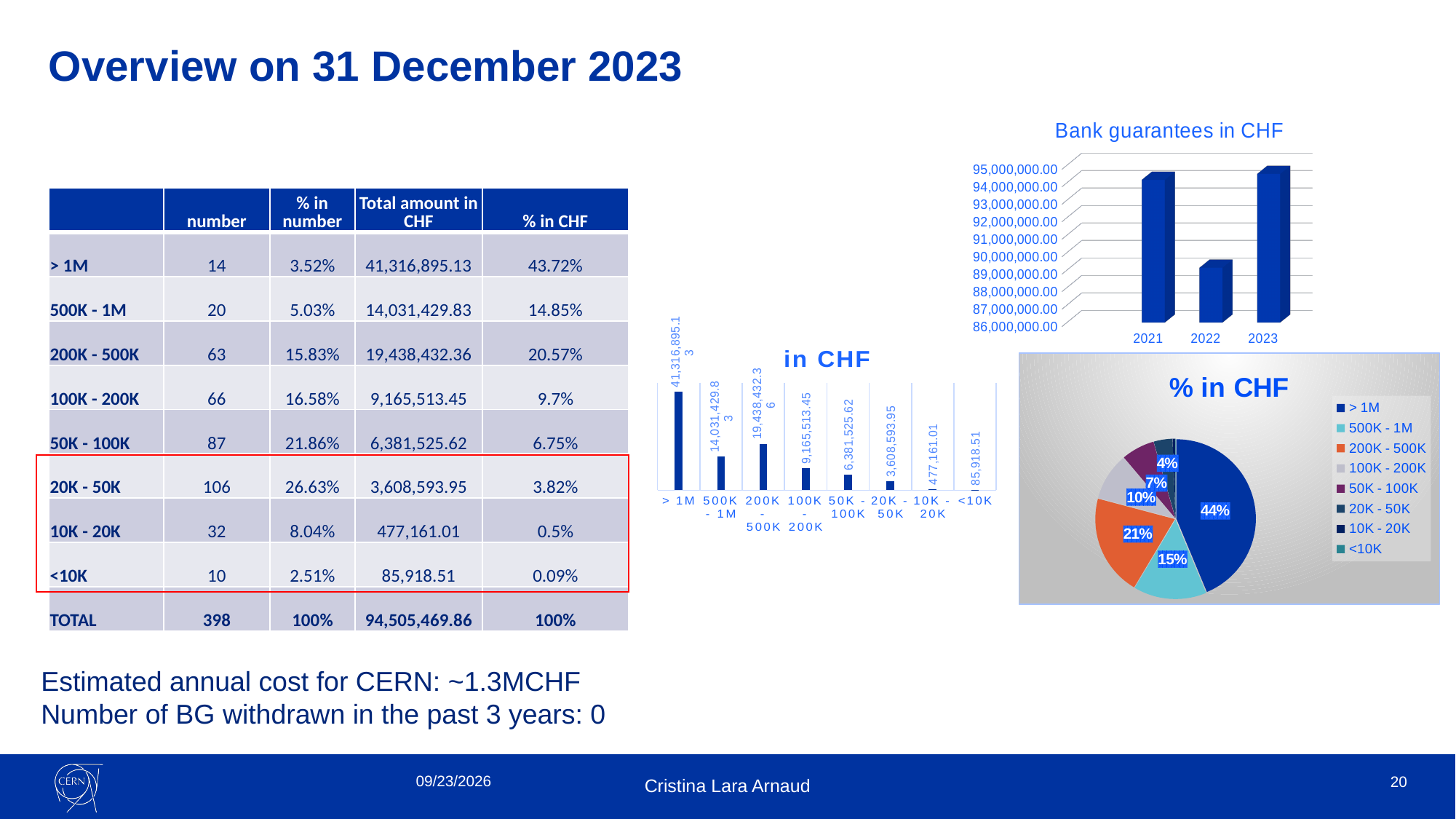
In the '% in CHF' pie chart, what share does the > 1M slice have? 44% In the 'in CHF' bar chart, what is the value for the 50K - 100K category? 6,381,525.62 In the 'in CHF' bar chart, which category has the lowest value? <10K How many entries does the legend of the '% in CHF' pie chart list? 8 In the 'in CHF' bar chart, which is larger, the value for 100K - 200K or the value for 20K - 50K? 100K - 200K In the 'Bank guarantees in CHF' chart, is the value for 2022 greater or less than 92,000,000.00? less In the 'in CHF' bar chart, what is the value for the > 1M category? 41,316,895.13 In the 'in CHF' bar chart, which category has the highest value? > 1M In the 'Bank guarantees in CHF' chart, which year has the lowest value? 2022 In the '% in CHF' pie chart, what share does the 200K - 500K slice have? 21% In the 'in CHF' bar chart, what is the difference between the values for 200K - 500K and 500K - 1M? 5,407,002.53 In the 'in CHF' bar chart, how many categories are shown on the x axis? 8